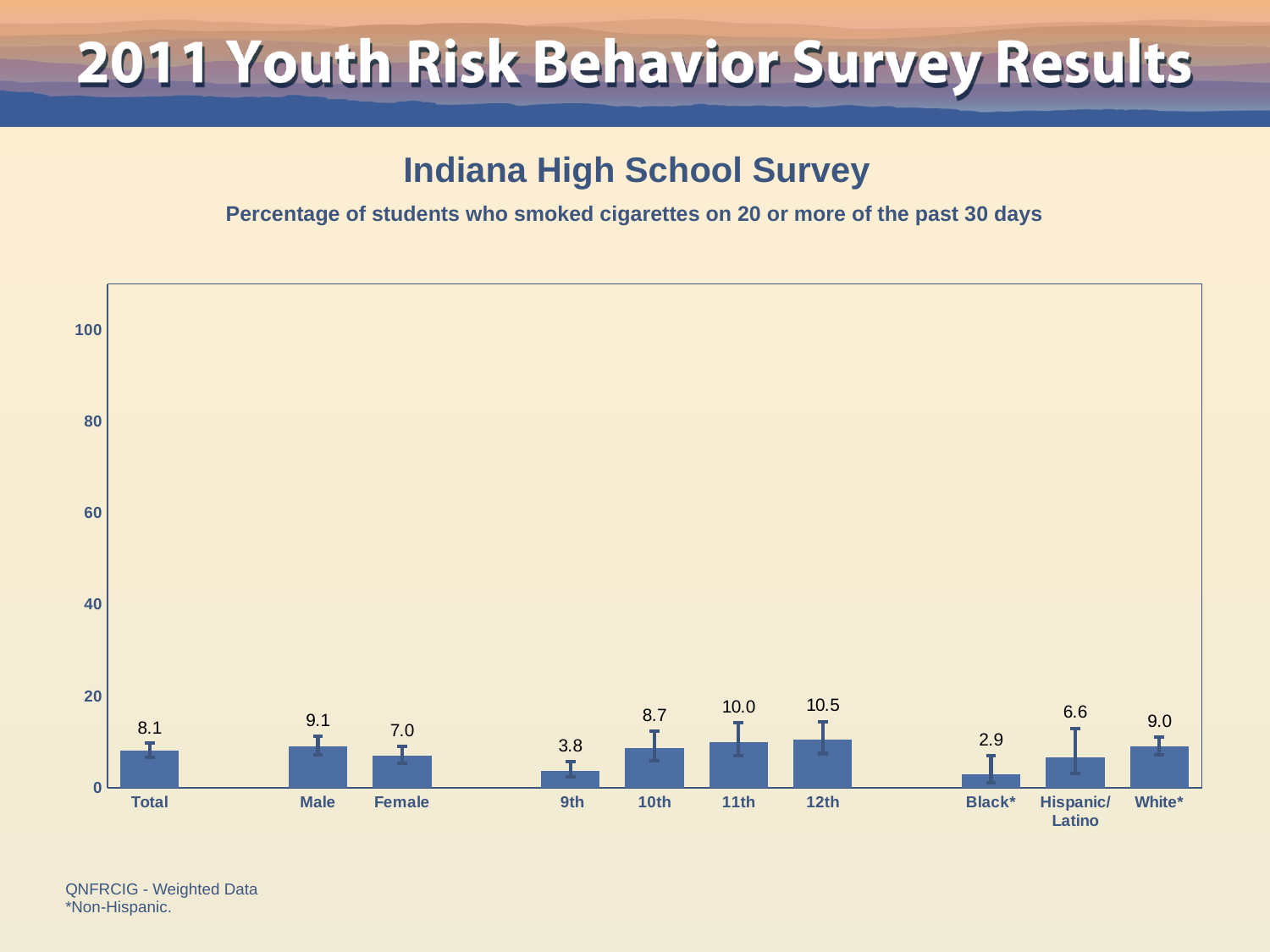
Which is larger, the value for White* or the value for Hispanic/Latino? White* Do the values rise or fall from 9th grade to 12th grade? rise What is the difference between the values for 12th and 9th grade? 6.7 Is the value for 11th grade greater or less than 20? less What is the value for 9th grade students? 3.8 What is the value for Total? 8.1 Which category has the lowest value? Black* What is the difference between the values for Male and Female? 2.1 How many categories are shown on the x axis? 10 What is the value for Hispanic/Latino students? 6.6 Which category has the highest value? 12th What kind of chart is shown on the slide? bar chart